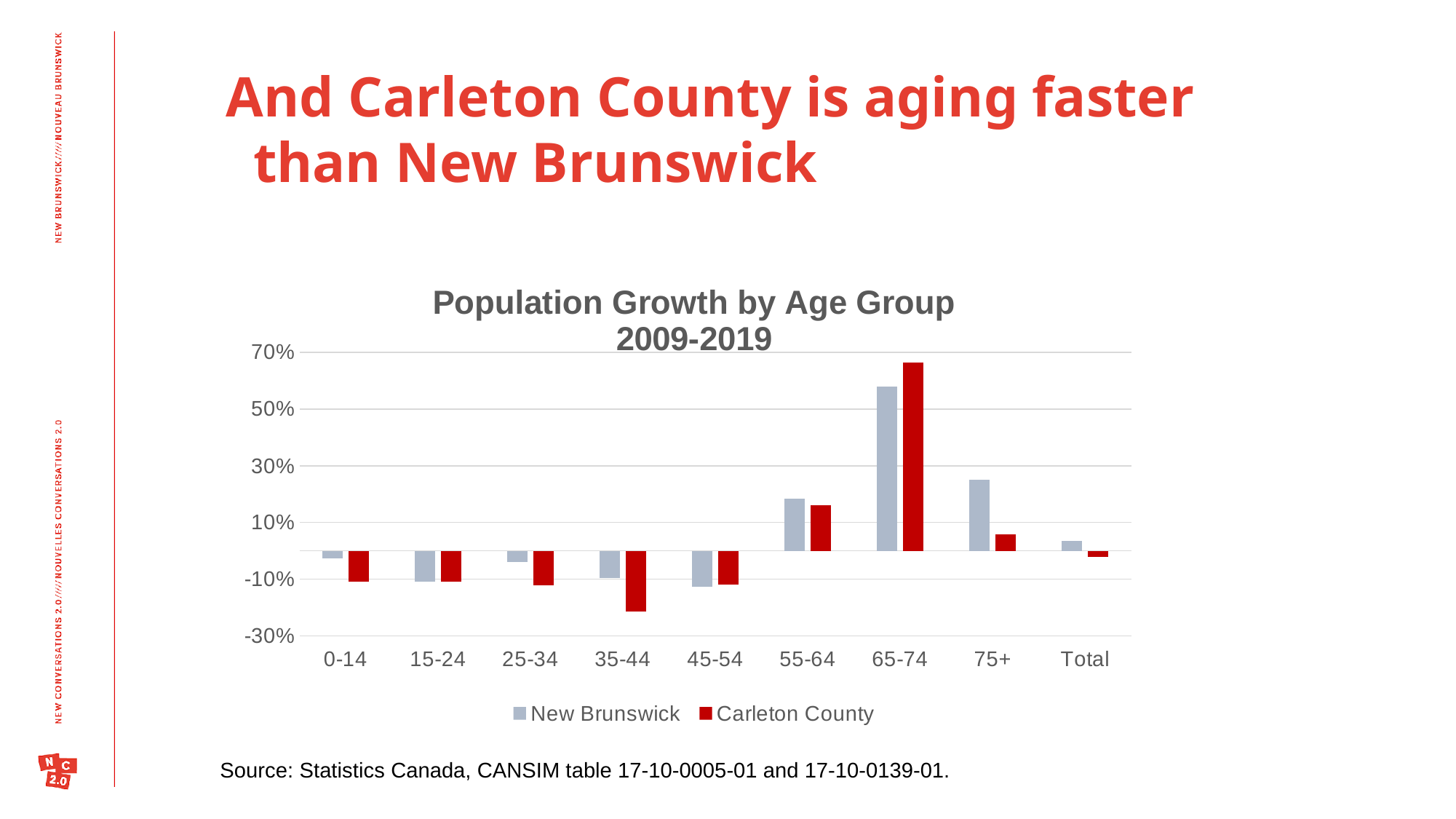
Which age group has the lowest population growth for Carleton County? 35-44 How many series does the legend list? 2 For the 75+ age group, which series has the larger value, New Brunswick or Carleton County? New Brunswick Which age group has the highest population growth for Carleton County? 65-74 Which age group has the highest population growth for New Brunswick? 65-74 Is the Carleton County value for 65-74 greater or less than 50%? greater What kind of chart is shown on the slide? Bar chart Is the New Brunswick value for 75+ greater or less than 10%? greater What is the title of the chart? Population Growth by Age Group 2009-2019 For the 65-74 age group, which series has the larger value, New Brunswick or Carleton County? Carleton County How many age-group categories (including Total) are shown on the x axis? 9 Is the Carleton County value for 35-44 greater or less than -10%? less